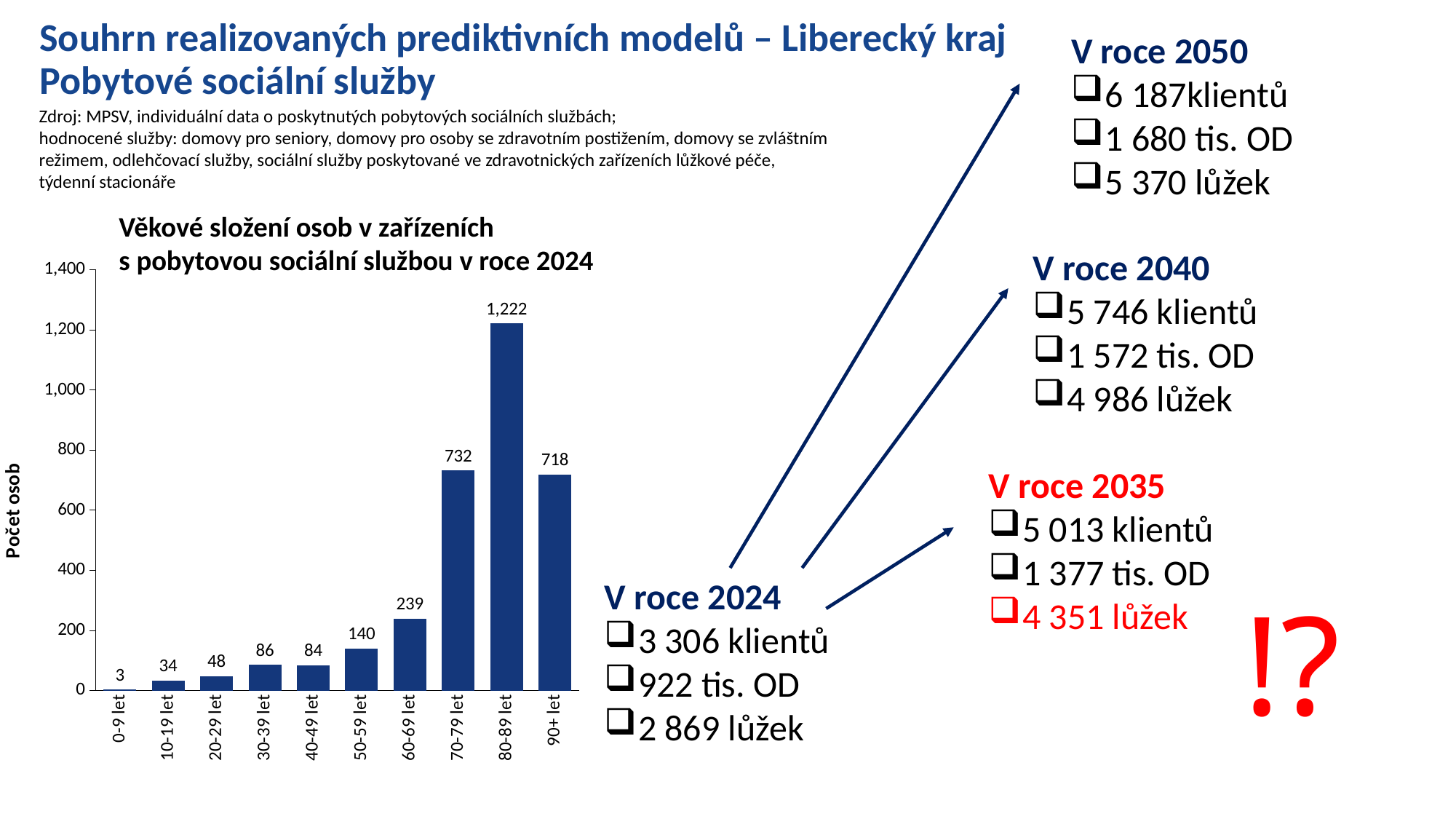
What is the value for the 80-89 let age group? 1,222 Which age group has the lowest number of persons? 0-9 let Which is larger, the value for 30-39 let or the value for 40-49 let? 30-39 let What kind of chart is shown on the slide? bar chart What is the value for the 0-9 let age group? 3 What is the difference between the values for 80-89 let and 70-79 let? 490 Is the value for 50-59 let greater or less than 200? less What is the difference between the values for 70-79 let and 90+ let? 14 How many age groups are shown on the x axis? 10 What is the label of the y axis? Počet osob Which age group has the highest number of persons? 80-89 let What is the value for the 60-69 let age group? 239